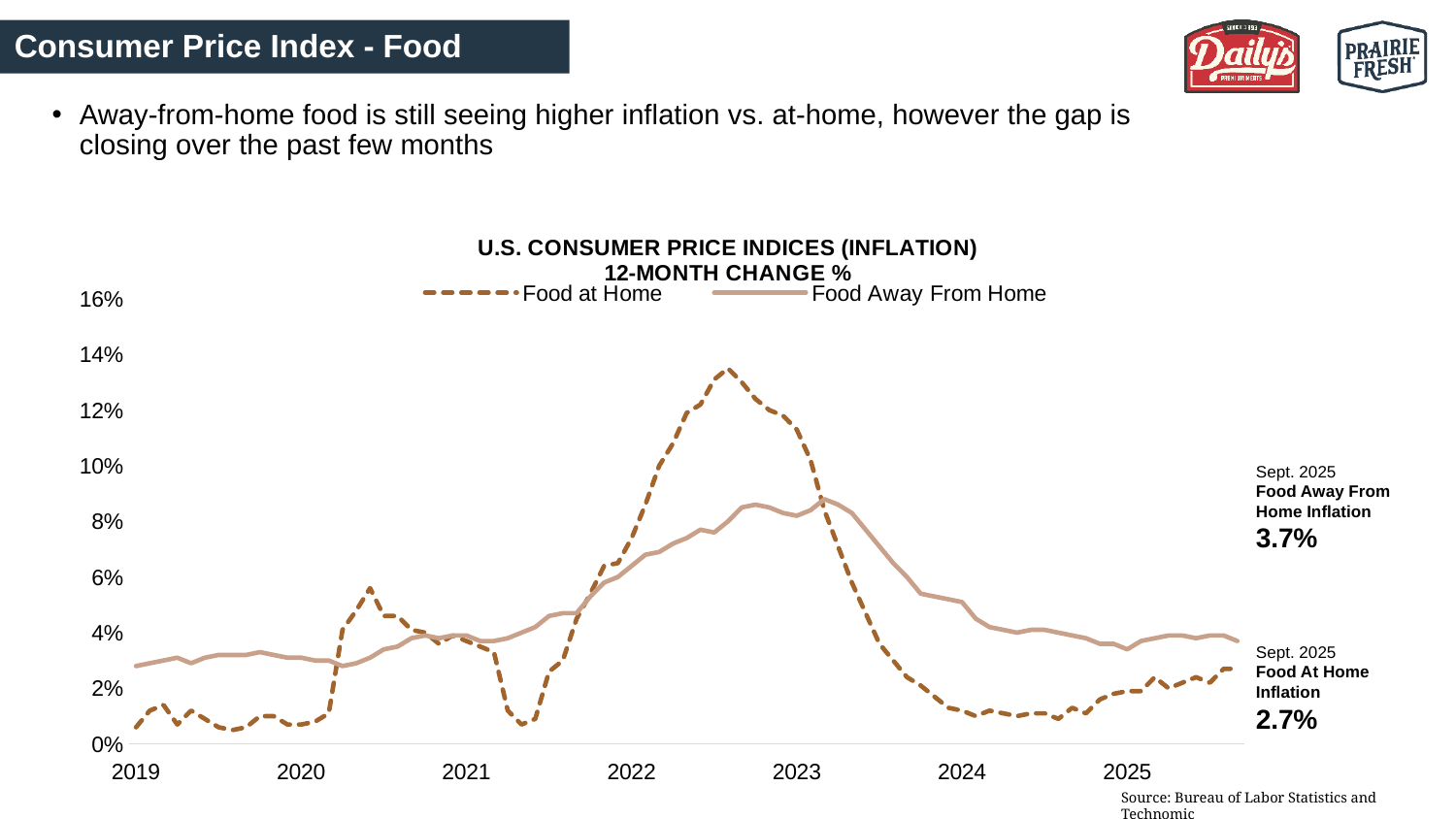
In Sept. 2025, which series has the higher inflation value, Food at Home or Food Away From Home? Food Away From Home Is the peak value for Food at Home greater or less than 12%? greater Which series is drawn with a dashed line? Food at Home Is the value for Food at Home at the start of 2019 greater or less than 2%? less How many series does the chart legend list? 2 Is the peak value for Food Away From Home greater or less than 10%? less What is the difference between Food Away From Home inflation and Food At Home inflation in Sept. 2025? 1.0% What is the Food At Home inflation value for Sept. 2025? 2.7% Which series reaches the highest peak on the chart? Food at Home Does the Food at Home series rise or fall between 2023 and 2024? fall What kind of chart is shown on the slide? line chart What is the Food Away From Home inflation value for Sept. 2025? 3.7%